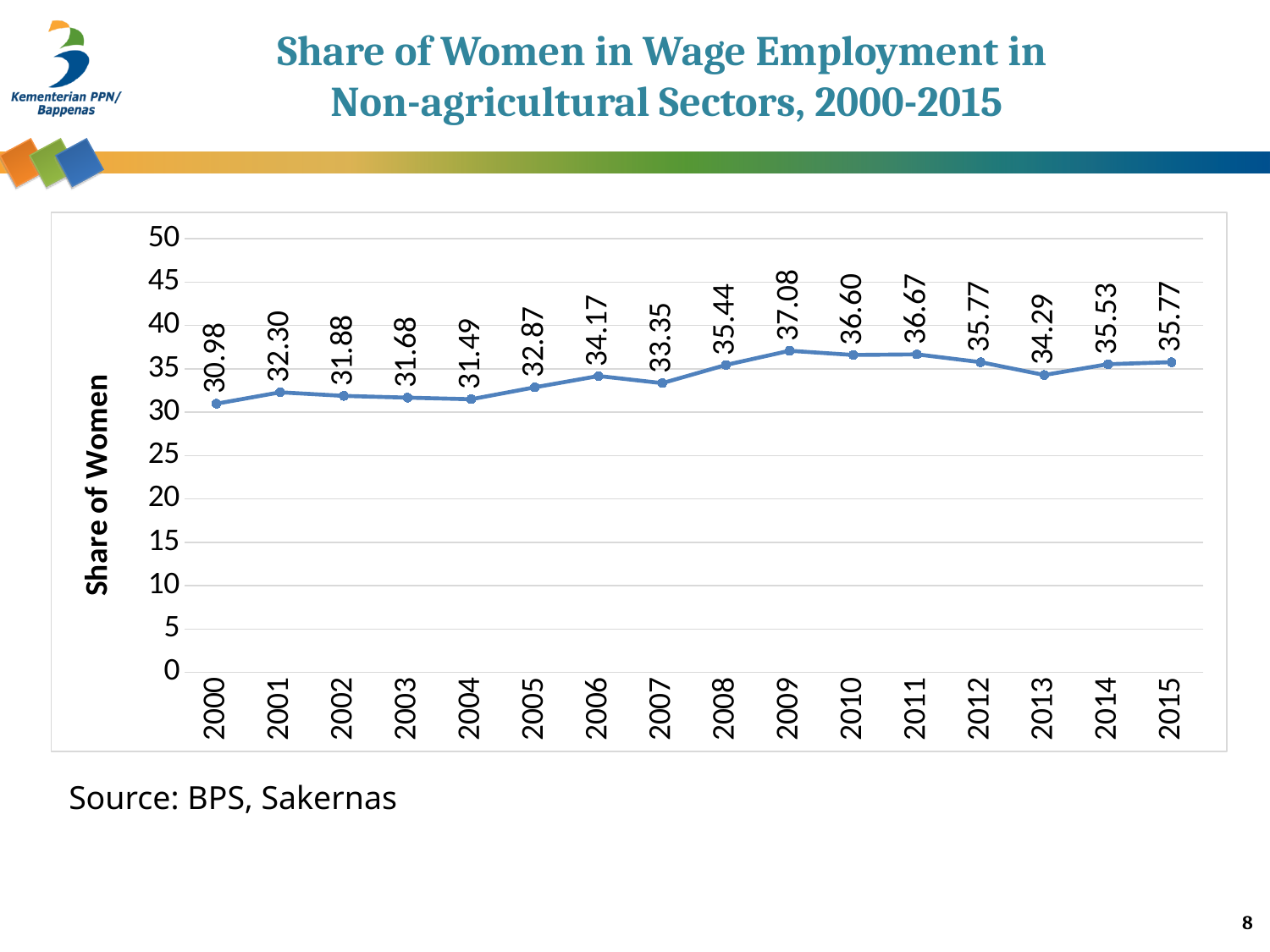
How many years are plotted on the chart? 16 What is the share of women in wage employment in non-agricultural sectors in 2015? 35.77 What is the difference between the share of women in 2009 and in 2000? 6.10 Is the share of women in wage employment in 2004 greater or less than 35? less Which year has a larger share of women in wage employment, 2006 or 2007? 2006 What is the label of the vertical axis of the chart? Share of Women Which year has the highest share of women in wage employment in non-agricultural sectors? 2009 What kind of chart is shown on the slide? line chart What is the share of women in wage employment in non-agricultural sectors in 2013? 34.29 Which year has the lowest share of women in wage employment in non-agricultural sectors? 2000 What is the share of women in wage employment in non-agricultural sectors in 2009? 37.08 What is the share of women in wage employment in non-agricultural sectors in 2000? 30.98